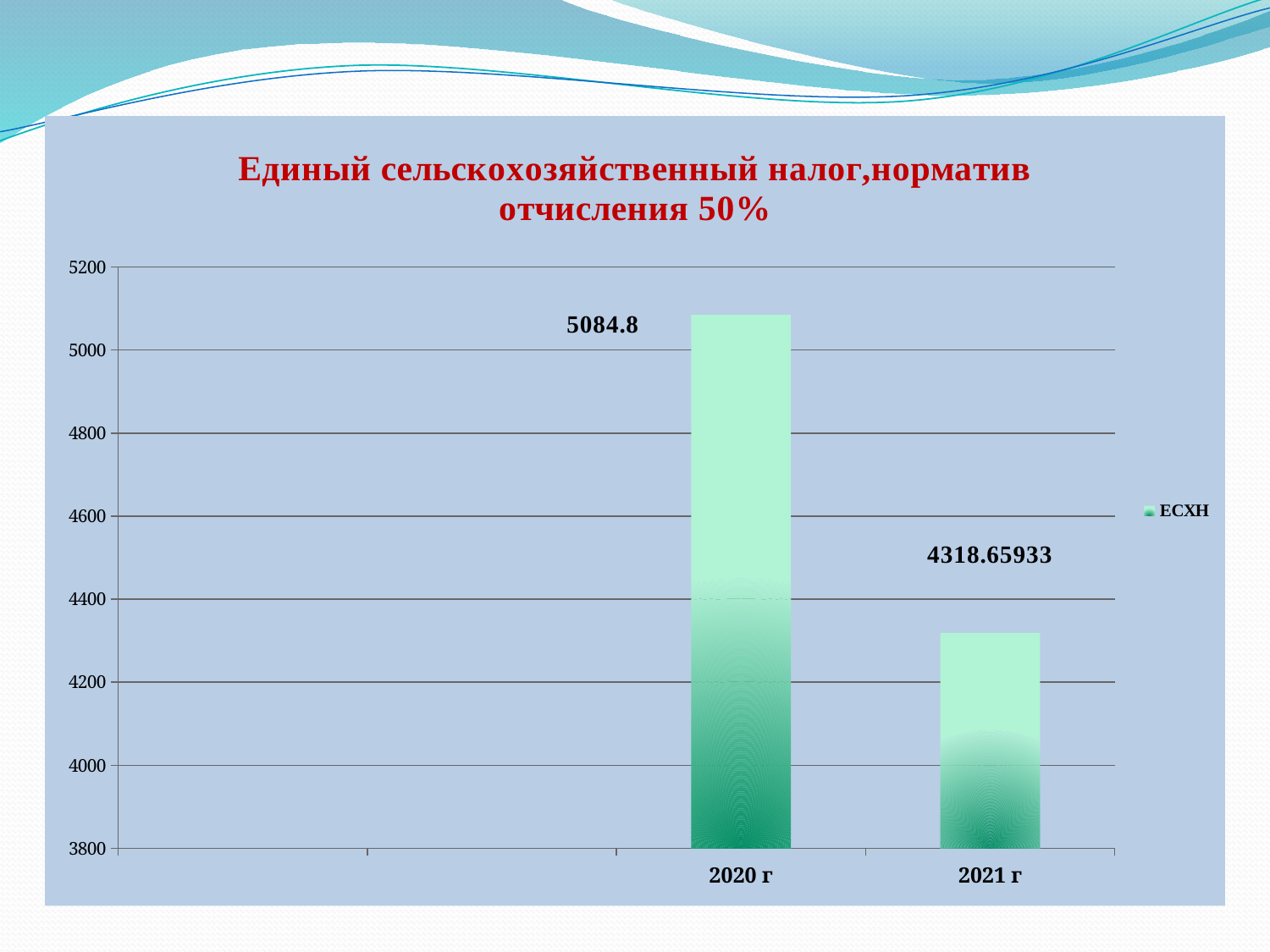
Which year has the highest value? 2020 г How many series does the legend list? 1 What is the value for 2021 г? 4318.65933 How many categories are shown on the x axis? 2 Is the value for 2020 г greater or less than 5000? greater What kind of chart is shown on the slide? bar chart What is the name of the series in the legend? ЕСХН What is the value for 2020 г? 5084.8 What is the difference between the values for 2020 г and 2021 г? 766.14067 Which is larger, the value for 2020 г or the value for 2021 г? 2020 г Which year has the lowest value? 2021 г Is the value for 2021 г greater or less than 4400? less